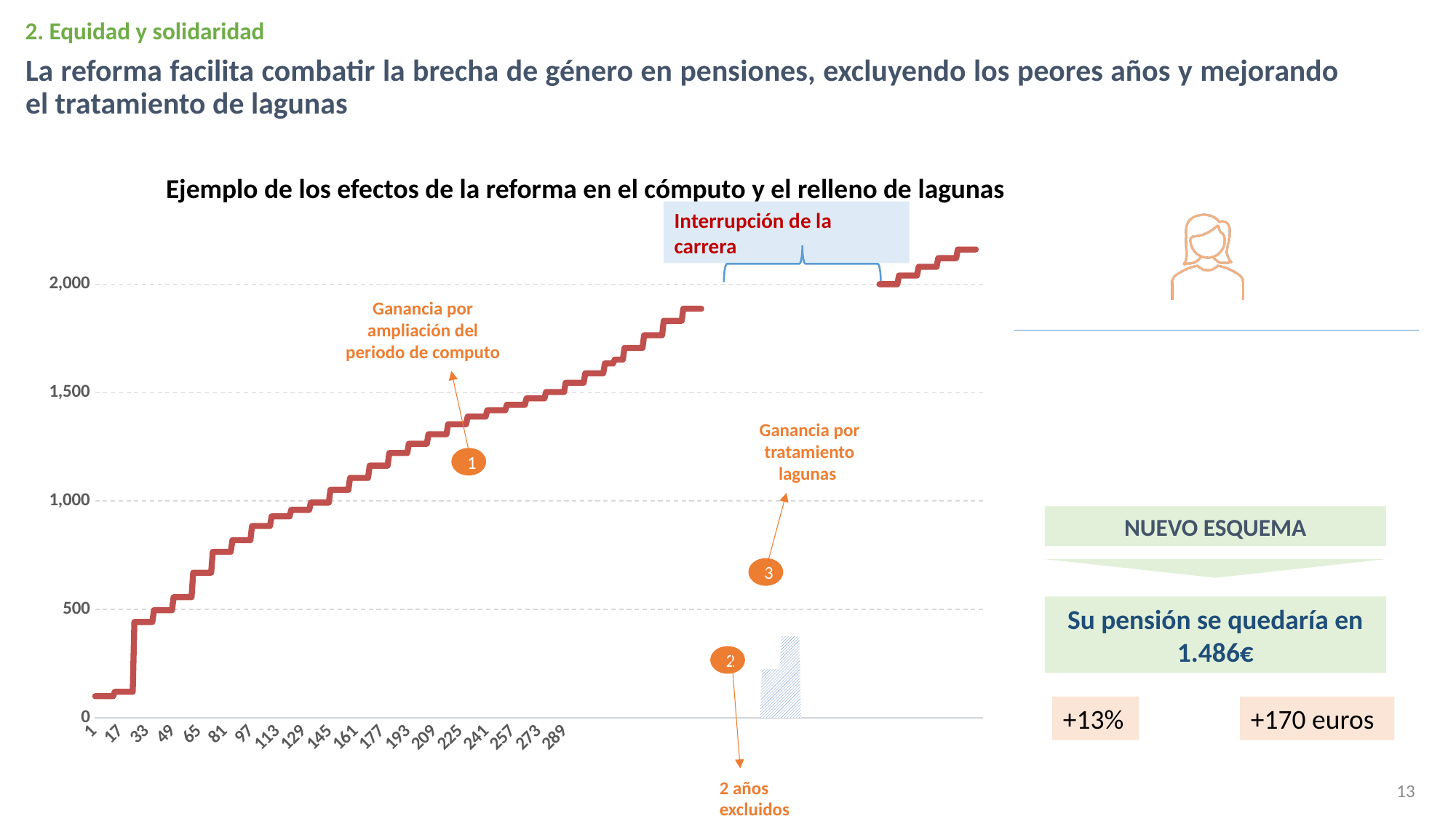
Is the value of the line at x = 97 greater or less than 500? greater Is the value of the line at its right-hand end greater or less than 2,000? greater Is the value of the line at x = 1 greater or less than 500? less Do the values of the line generally rise or fall along the x axis? rise What kind of chart is shown on the slide? line chart What is the last label shown on the x axis? 289 What is the title of the chart? Ejemplo de los efectos de la reforma en el cómputo y el relleno de lagunas What is the highest value labelled on the y axis? 2,000